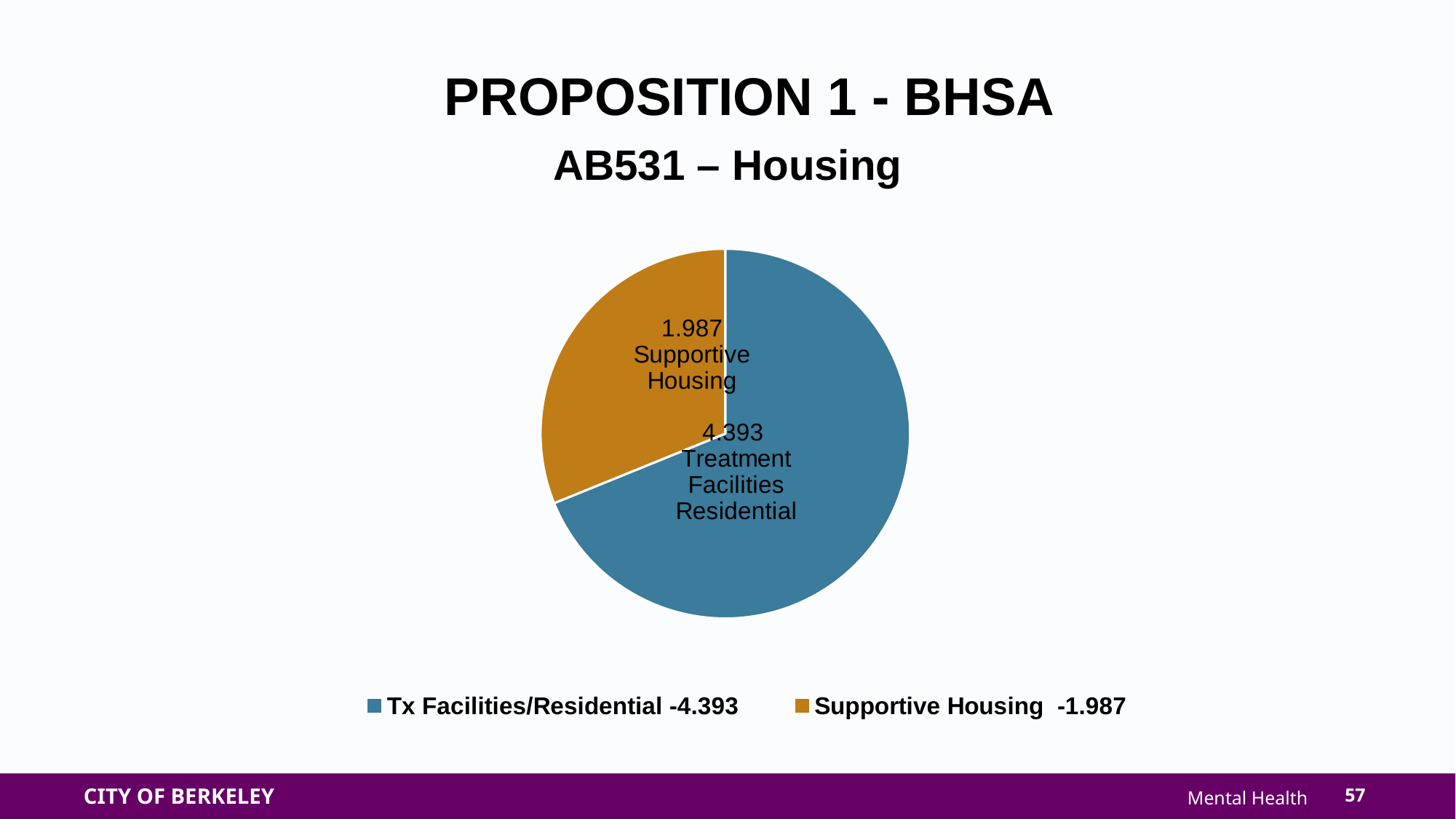
Which slice of the pie is the smallest? Supportive Housing How many slices does the pie chart have? 2 What is the value for Treatment Facilities Residential? 4.393 Which slice of the pie is the largest? Treatment Facilities Residential Which is larger, Supportive Housing or Treatment Facilities Residential? Treatment Facilities Residential What is the value for Supportive Housing? 1.987 What is the total of the two slices in the pie chart? 6.380 What is the subtitle shown above the pie chart? AB531 – Housing How many entries does the legend list? 2 What type of chart is shown on the slide? Pie chart What colour is the Supportive Housing slice? Orange What is the difference between the Treatment Facilities Residential value and the Supportive Housing value? 2.406